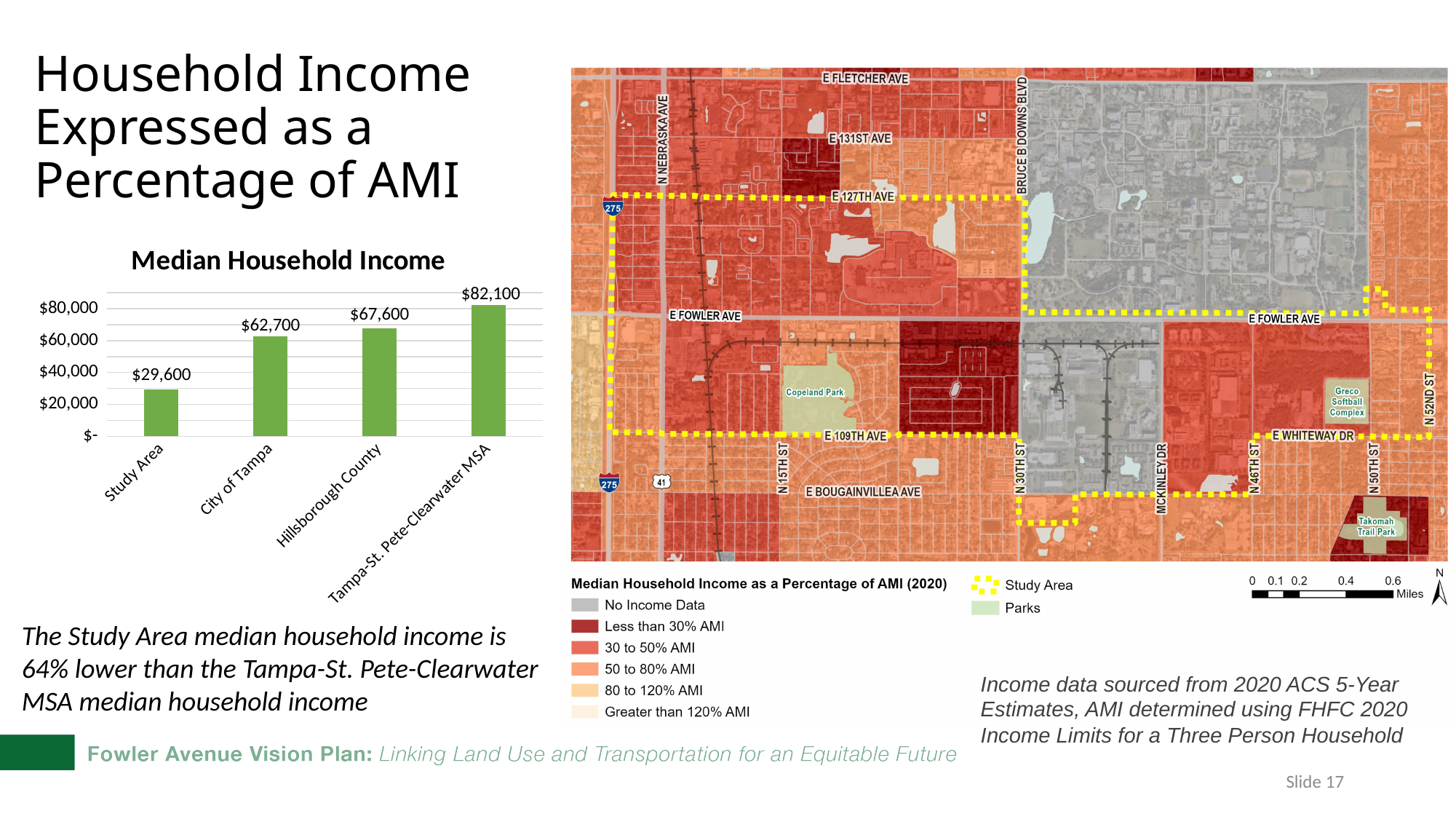
What is the difference in median household income between Hillsborough County and the City of Tampa? $4,900 What is the median household income for the City of Tampa? $62,700 What is the median household income for the Tampa-St. Pete-Clearwater MSA? $82,100 What is the median household income for the Study Area? $29,600 How many categories are shown in the Median Household Income chart? 4 Which category has the lowest median household income? Study Area What type of chart is the Median Household Income chart? bar chart What is the difference in median household income between the Tampa-St. Pete-Clearwater MSA and the Study Area? $52,500 What is the median household income for Hillsborough County? $67,600 Is the median household income for the Study Area greater or less than $40,000? less Which category has the highest median household income? Tampa-St. Pete-Clearwater MSA Which has a higher median household income, the City of Tampa or Hillsborough County? Hillsborough County